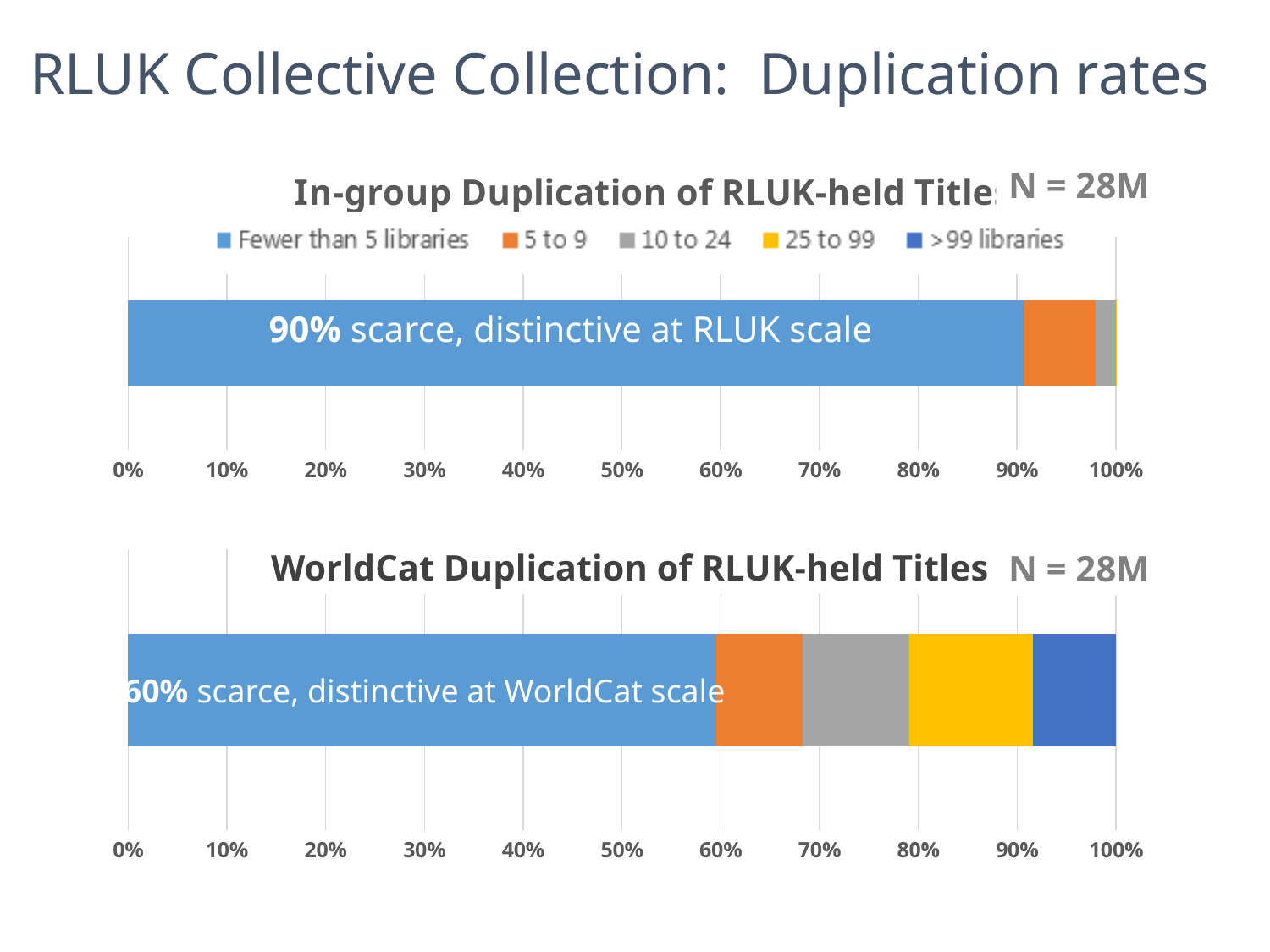
Is the 'Fewer than 5 libraries' segment larger in the top chart (In-group Duplication) or the bottom chart (WorldCat Duplication)? Top chart (In-group Duplication) What is the title of the bottom chart? WorldCat Duplication of RLUK-held Titles How many bars are plotted in the bottom chart, 'WorldCat Duplication of RLUK-held Titles'? 1 How many series does the legend of the top chart list? 5 In the top chart, 'In-group Duplication of RLUK-held Titles', which series has the largest segment? Fewer than 5 libraries In the bottom chart, 'WorldCat Duplication of RLUK-held Titles', which series has the largest segment? Fewer than 5 libraries In the bottom chart, 'WorldCat Duplication of RLUK-held Titles', is the value for 'Fewer than 5 libraries' greater or less than 70%? less In the bottom chart, 'WorldCat Duplication of RLUK-held Titles', which segment is larger: '25 to 99' or '5 to 9'? 25 to 99 In the top chart, 'In-group Duplication of RLUK-held Titles', is the value for 'Fewer than 5 libraries' greater or less than 80%? greater In the bottom chart, 'WorldCat Duplication of RLUK-held Titles', is the value for '10 to 24' greater or less than 20%? less What type of chart is the top chart, 'In-group Duplication of RLUK-held Titles'? Stacked bar chart What sample size (N) is shown next to the title of the top chart? N = 28M